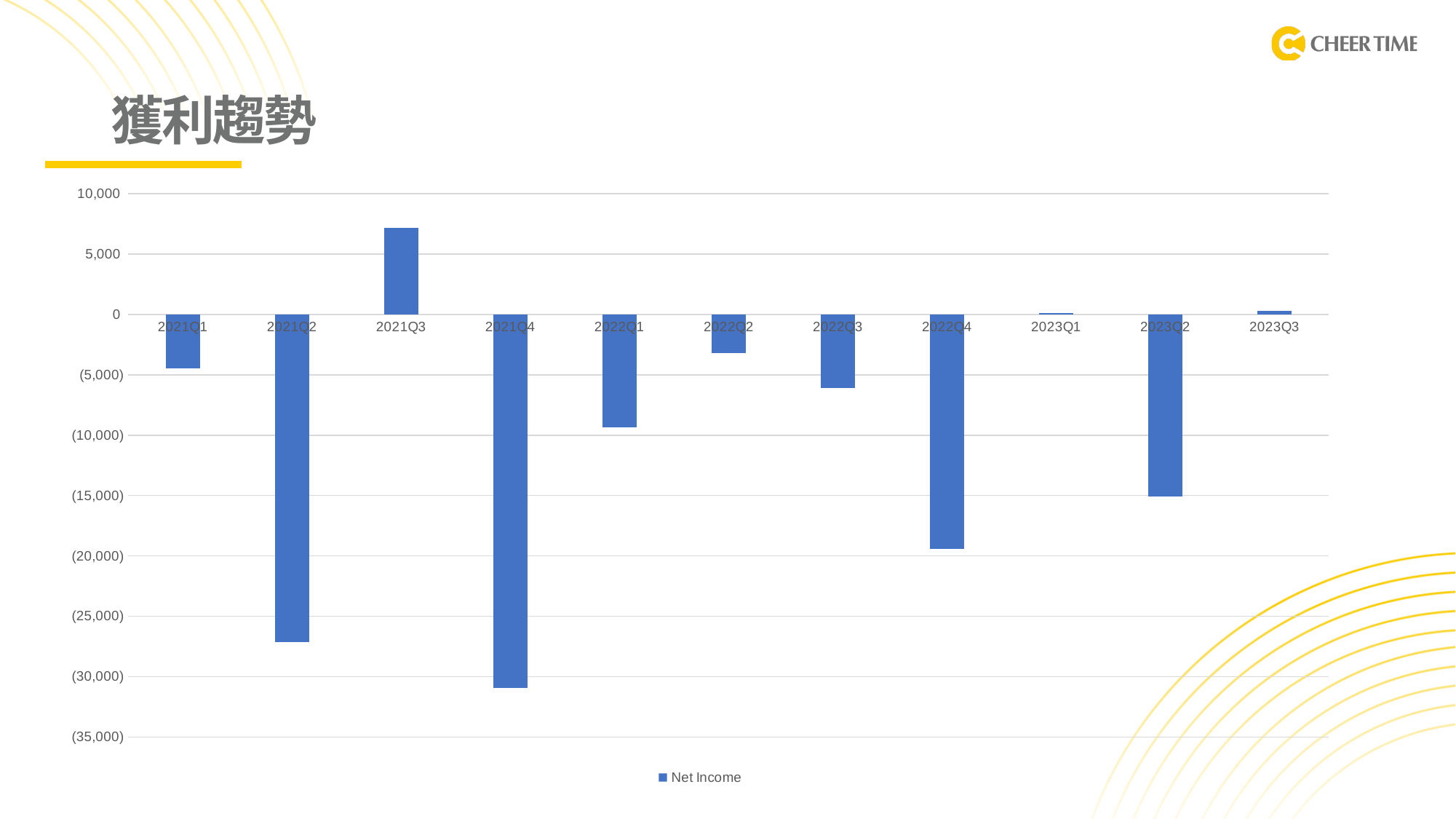
Is the Net Income for 2021Q2 greater or less than (25,000)? less Which quarter has the lowest Net Income? 2021Q4 Which quarter has the highest Net Income? 2021Q3 How many series does the legend list? 1 Is the Net Income for 2022Q4 greater or less than (15,000)? less Is the Net Income for 2022Q1 greater or less than (5,000)? less How many quarters are plotted on the x axis? 11 Which quarter has the larger Net Income, 2022Q4 or 2023Q2? 2023Q2 What is the name of the series shown in the legend? Net Income What kind of chart is shown on the slide? Bar chart Which quarter has the larger Net Income, 2022Q1 or 2022Q2? 2022Q2